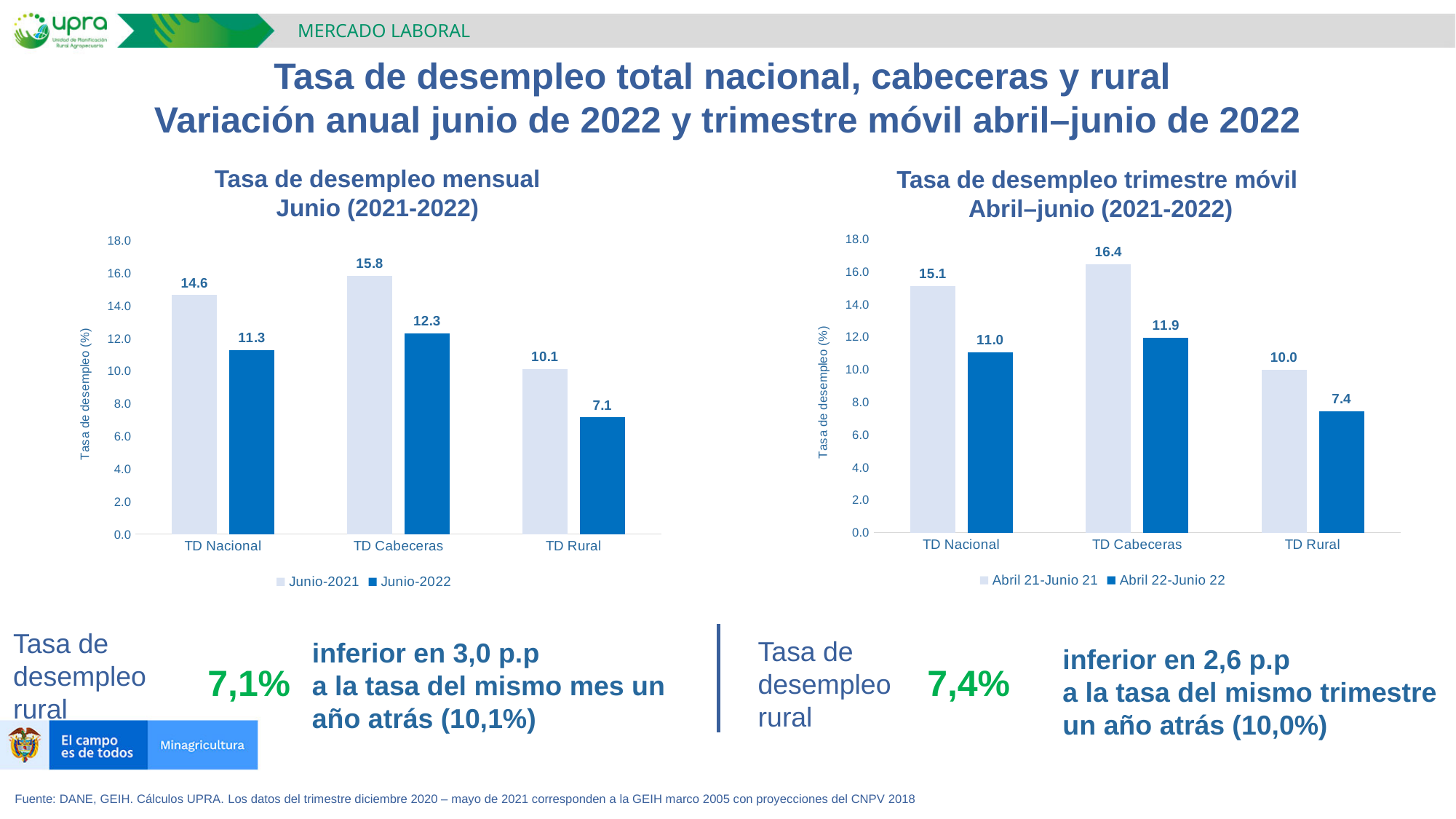
What type of chart is the 'Tasa de desempleo mensual Junio (2021-2022)' chart? Bar chart In the 'Tasa de desempleo trimestre móvil Abril–junio (2021-2022)' chart, what is the difference between the Abril 21-Junio 21 and Abril 22-Junio 22 values for TD Cabeceras? 4.5 How many categories are shown on the x axis of the 'Tasa de desempleo mensual Junio (2021-2022)' chart? 3 In the 'Tasa de desempleo mensual Junio (2021-2022)' chart, what is the value for TD Nacional in Junio-2022? 11.3 In the 'Tasa de desempleo trimestre móvil Abril–junio (2021-2022)' chart, what is the value for TD Rural in Abril 22-Junio 22? 7.4 In the 'Tasa de desempleo mensual Junio (2021-2022)' chart, what is the value for TD Cabeceras in Junio-2021? 15.8 How many series does the legend of the 'Tasa de desempleo trimestre móvil Abril–junio (2021-2022)' chart list? 2 What is the y-axis label of the 'Tasa de desempleo trimestre móvil Abril–junio (2021-2022)' chart? Tasa de desempleo (%) In the 'Tasa de desempleo trimestre móvil Abril–junio (2021-2022)' chart, which is larger: TD Nacional in Abril 22-Junio 22 or TD Cabeceras in Abril 22-Junio 22? TD Cabeceras in Abril 22-Junio 22 In the 'Tasa de desempleo trimestre móvil Abril–junio (2021-2022)' chart, which category has the highest value for Abril 21-Junio 21? TD Cabeceras In the 'Tasa de desempleo mensual Junio (2021-2022)' chart, what is the difference between the Junio-2021 and Junio-2022 values for TD Rural? 3.0 In the 'Tasa de desempleo mensual Junio (2021-2022)' chart, which category has the lowest value for Junio-2022? TD Rural